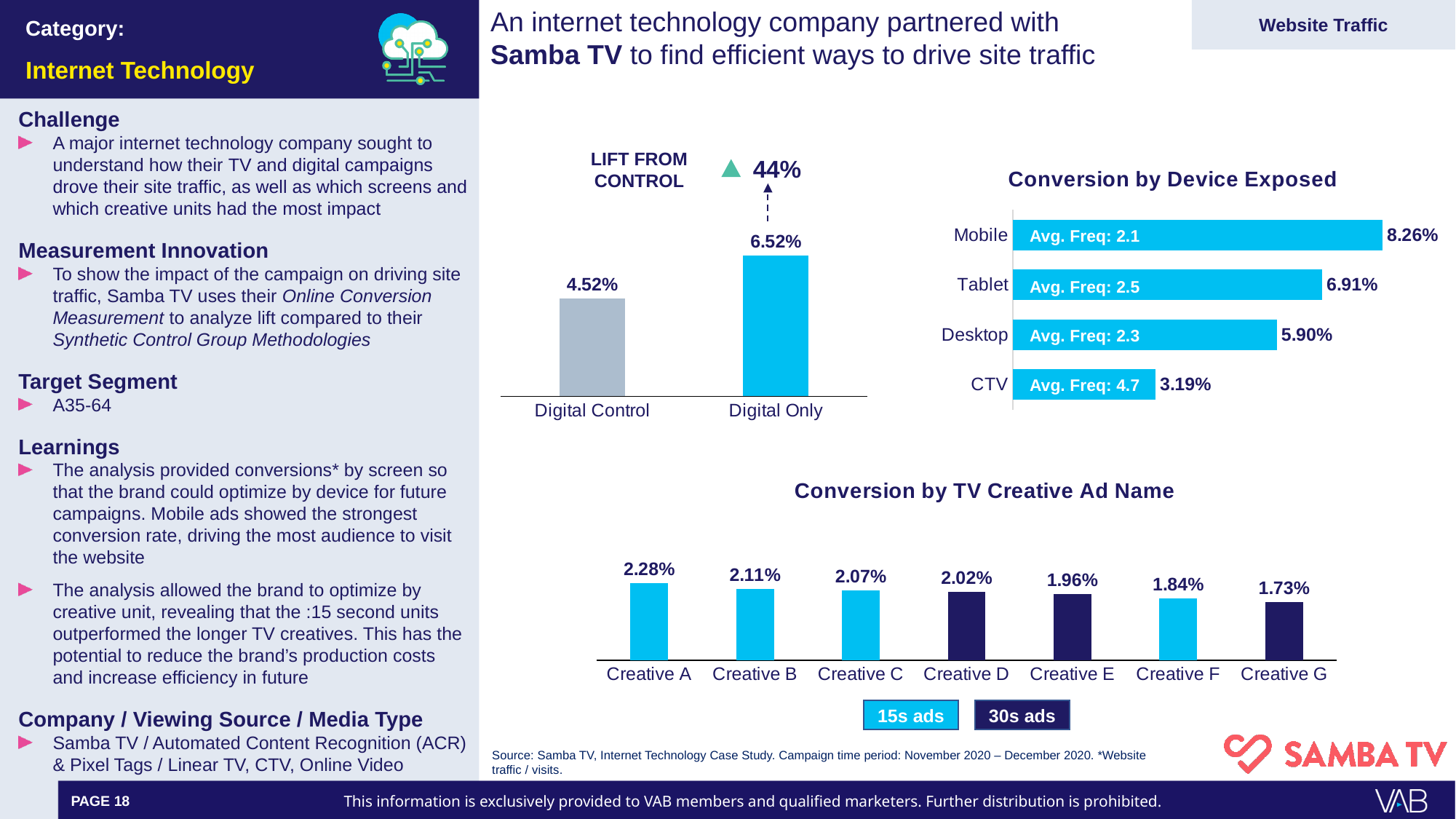
In the Conversion by TV Creative Ad Name chart, do the values rise or fall from Creative A to Creative G? fall In the Conversion by Device Exposed chart, what is the conversion value for Mobile? 8.26% In the Conversion by Device Exposed chart, what is the difference between the Tablet and Desktop conversion values? 1.01% In the Lift from Control chart, what is the value for Digital Only? 6.52% In the Conversion by Device Exposed chart, what is the average frequency shown for CTV? 4.7 In the Conversion by Device Exposed chart, how many devices are shown? 4 In the Conversion by TV Creative Ad Name chart, what is the value for Creative D? 2.02% In the Conversion by TV Creative Ad Name chart, which creative has the highest conversion? Creative A In the Conversion by Device Exposed chart, which device has the lowest conversion? CTV In the Conversion by TV Creative Ad Name chart, how many entries does the legend list? 2 In the Conversion by TV Creative Ad Name chart, what is the difference between Creative A and Creative G? 0.55% In the Lift from Control chart, what is the difference between Digital Only and Digital Control? 2.00%